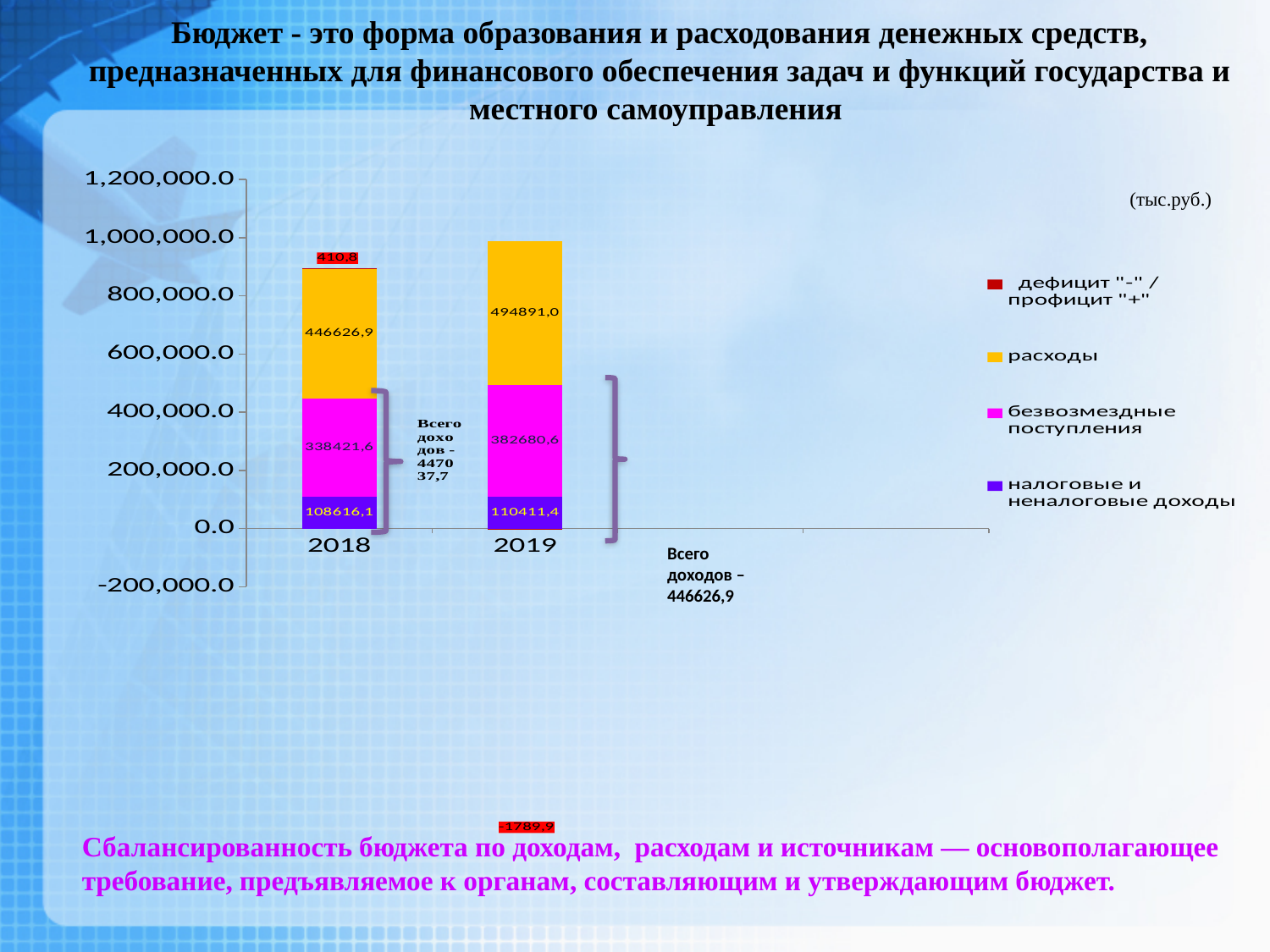
What is the difference between расходы in 2019 and in 2018? 48264,1 What is the value of расходы for 2018? 446626,9 Which year has the larger value for расходы, 2018 or 2019? 2019 What kind of chart is shown on the slide? stacked bar chart What is the value of безвозмездные поступления for 2019? 382680,6 What is the combined total of налоговые и неналоговые доходы and безвозмездные поступления for 2018? 447037,7 What is the value of налоговые и неналоговые доходы for 2018? 108616,1 What unit is indicated for the chart values? тыс.руб. What is the value of расходы for 2019? 494891,0 What is the value of дефицит/профицит for 2018? 410,8 How many series does the legend list? 4 How many years (categories) are shown on the x axis? 2